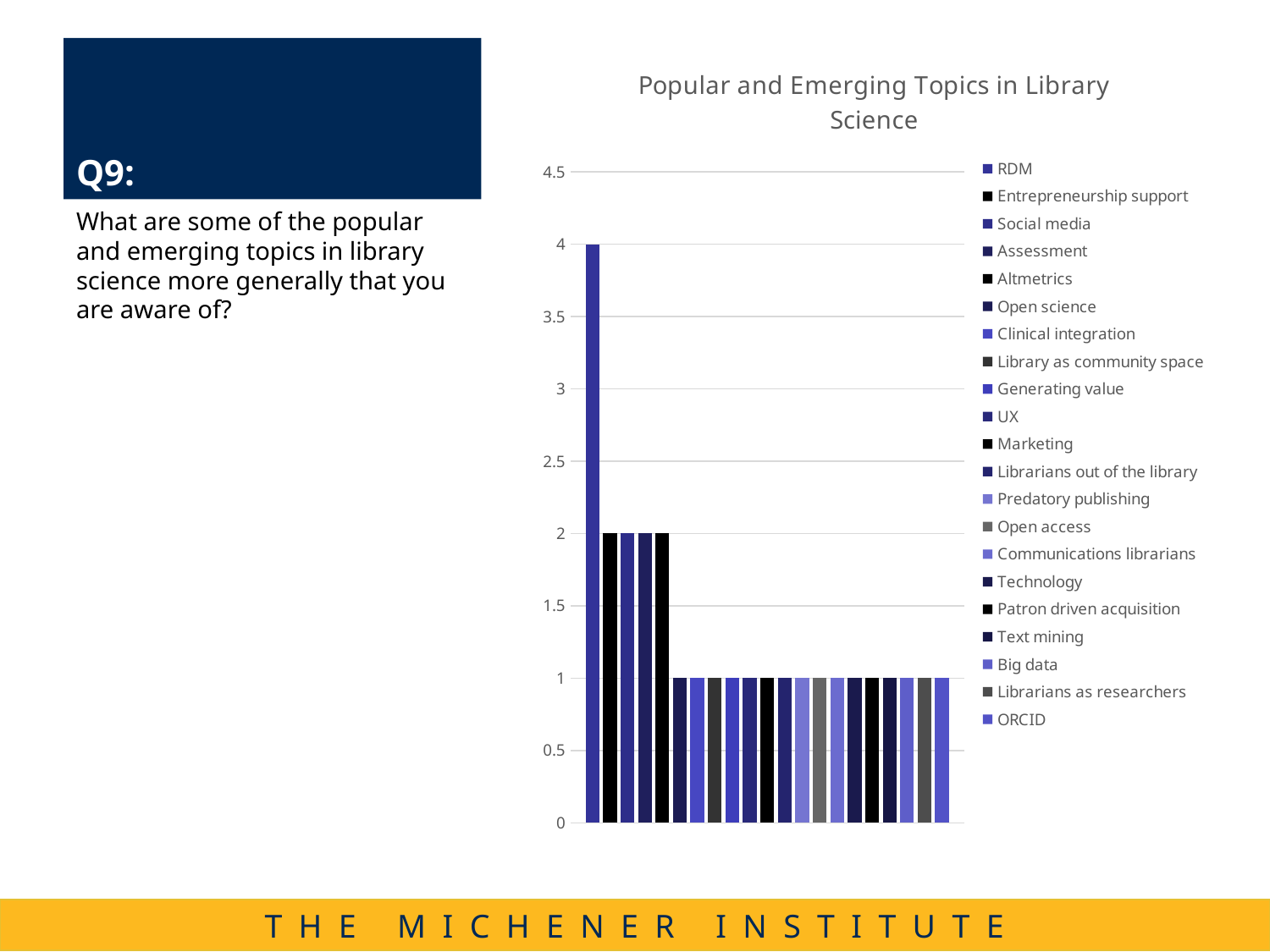
How many bars are plotted in the chart? 21 Which topic has the highest value in the chart? RDM What is the difference between the value for RDM and the value for Social media? 2 What kind of chart is shown on the slide? bar chart What is the title of the chart? Popular and Emerging Topics in Library Science Is the value for RDM greater or less than 3? greater What is the value for RDM? 4 What is the value for Entrepreneurship support? 2 Which is larger, the value for RDM or the value for Altmetrics? RDM How many series does the legend list? 21 Do the bar values rise or fall moving from left to right along the x axis? fall What is the value for ORCID? 1